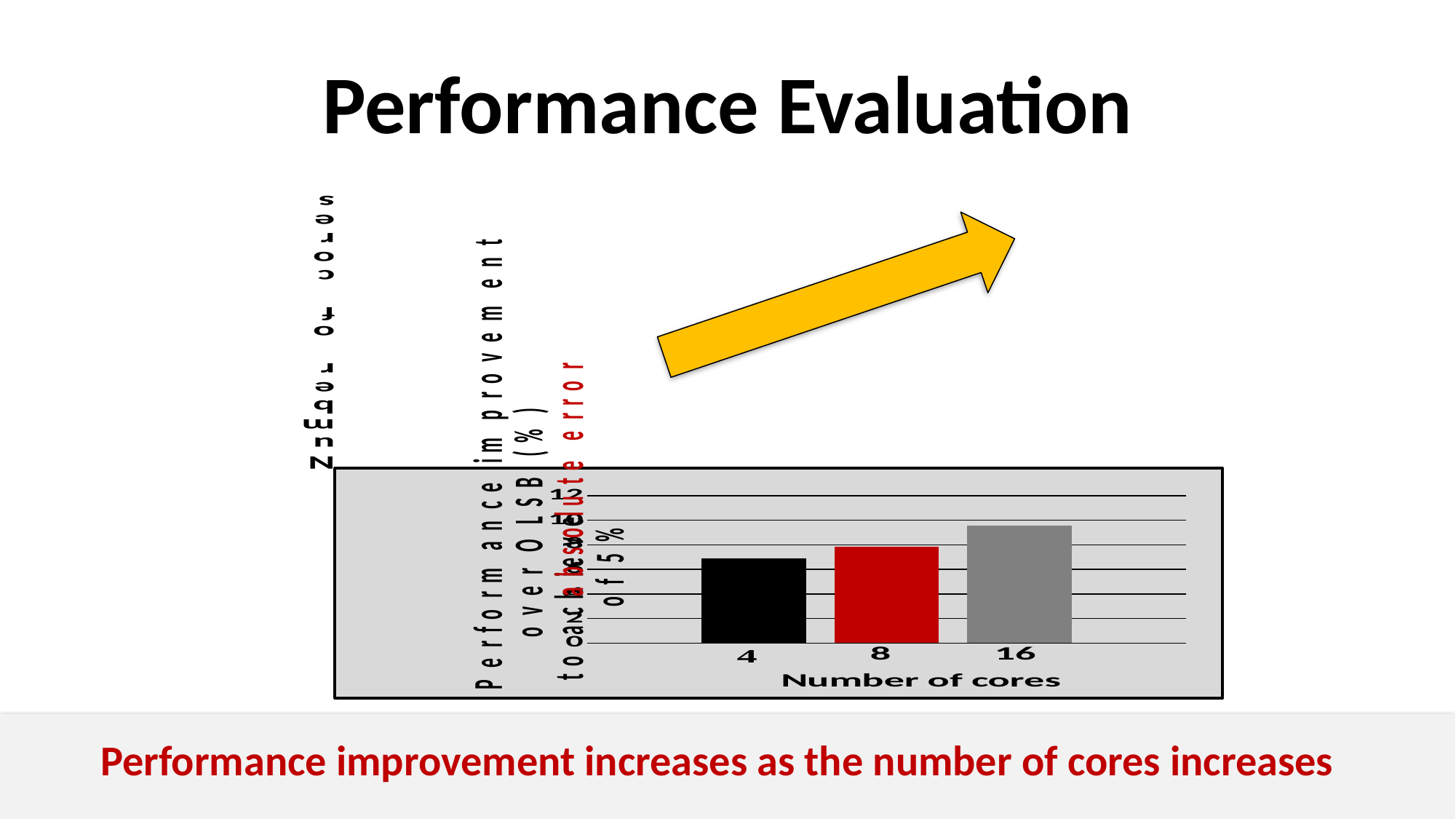
Which number of cores has the highest performance improvement? 16 What kind of chart is shown on the slide? bar chart What is the title of the x axis of the chart? Number of cores Which has a larger performance improvement, 4 cores or 8 cores? 8 How many bars (categories) are plotted in the chart? 3 Is the value for 16 cores greater or less than 10? less Which number of cores has the lowest performance improvement? 4 Is the value for 4 cores greater or less than 10? less Do the bar values rise or fall as the number of cores increases along the x axis? rise What colour is the bar for 8 cores? red Which has a larger performance improvement, 8 cores or 16 cores? 16